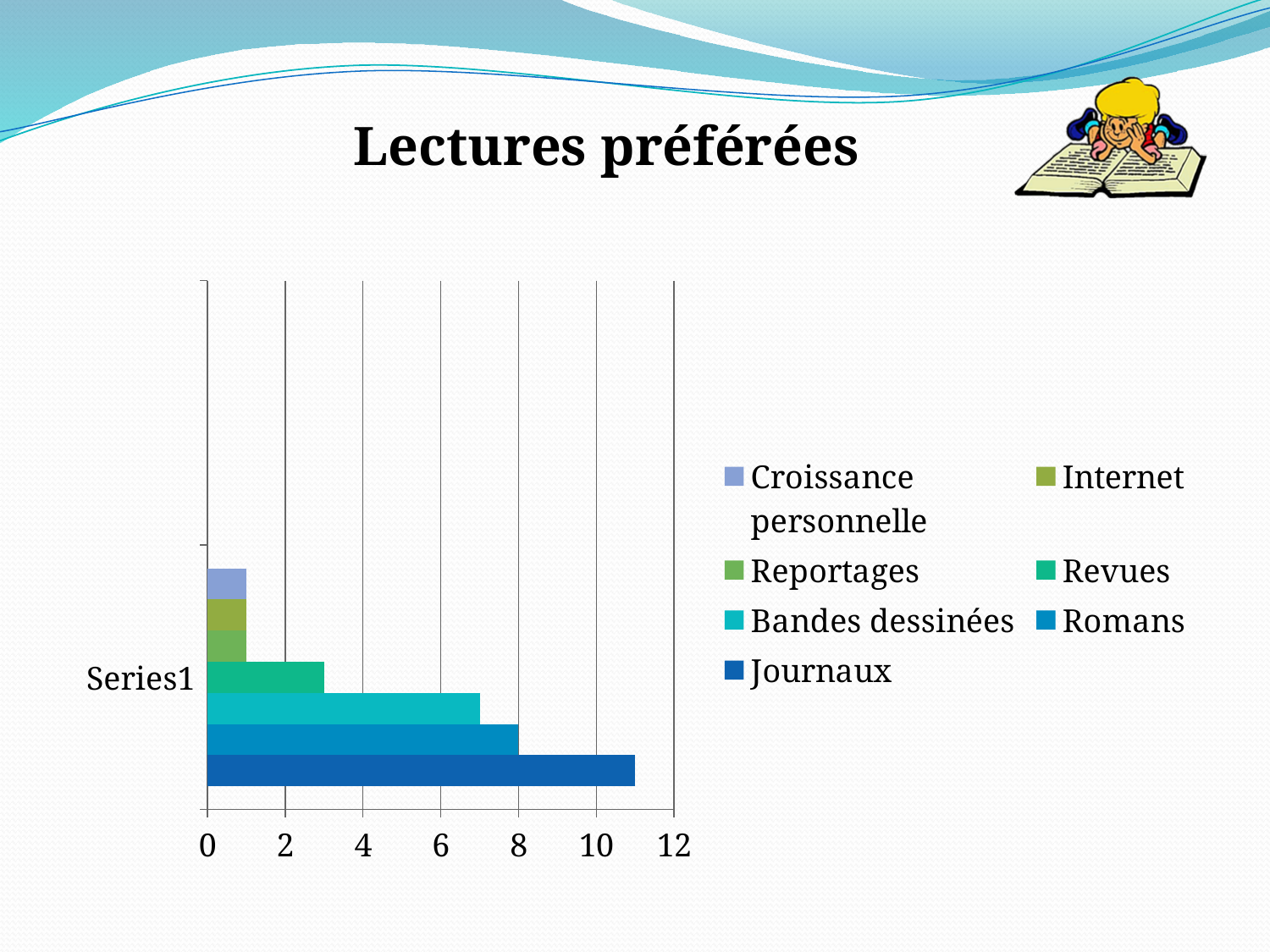
Is the value for Journaux greater or less than 10? greater Is the value for Bandes dessinées greater or less than 6? greater How many series does the legend list? 7 What label appears on the vertical axis of the chart? Series1 What is the value for Romans? 8 Which is larger, the value for Journaux or the value for Romans? Journaux What is the title of the slide above the chart? Lectures préférées Is the value for Croissance personnelle greater or less than 2? less Which series has the longest bar? Journaux What kind of chart is shown on the slide? bar chart Which is larger, the value for Bandes dessinées or the value for Revues? Bandes dessinées